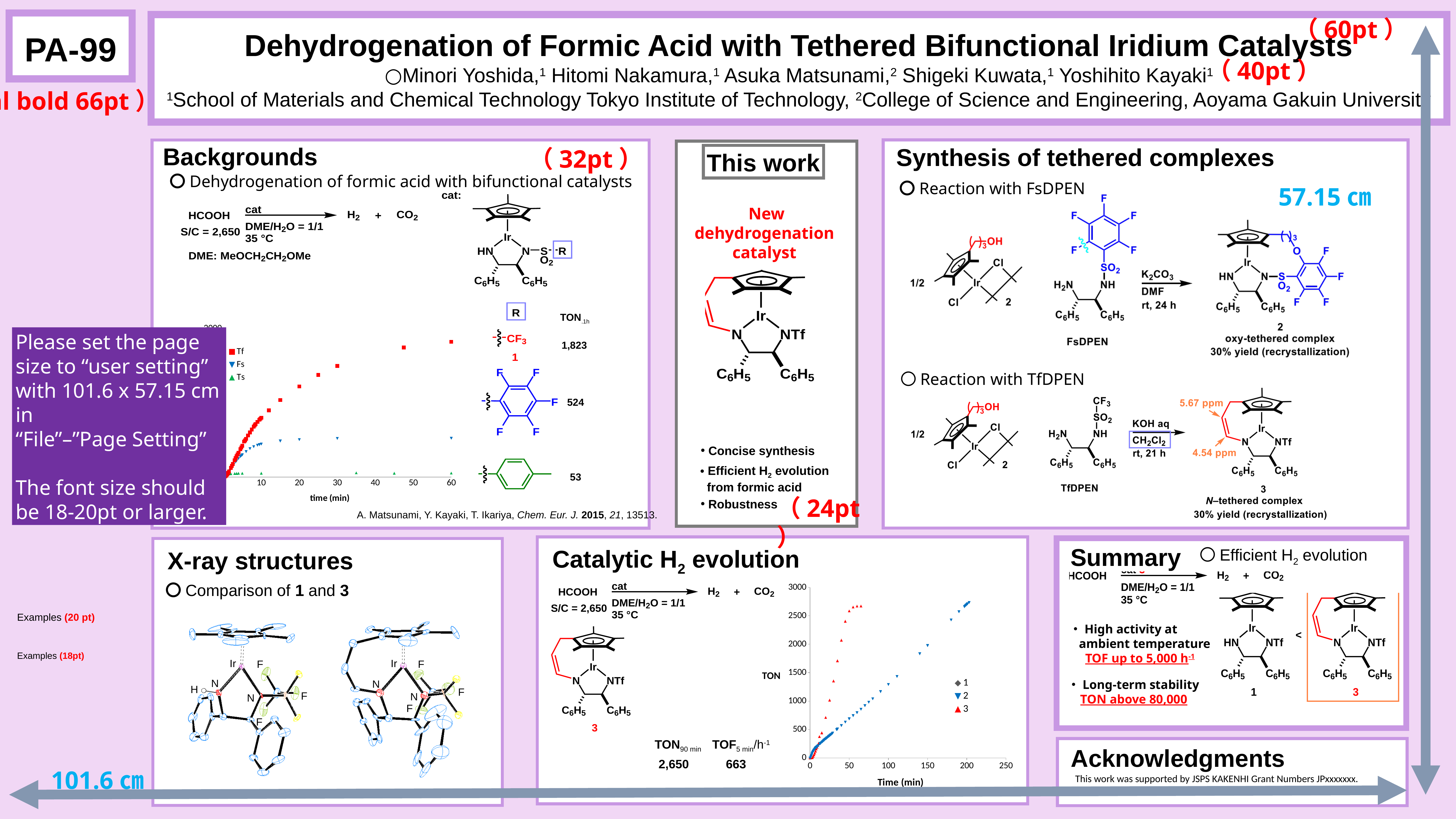
In the Catalytic H2 evolution chart, what is the label of the x axis? Time (min) In the Catalytic H2 evolution chart, which series reaches a TON of 2500 in the shortest time? 3 In the Backgrounds chart (TON vs time), how many series does the legend list? 3 In the Catalytic H2 evolution chart, how many series does the legend list? 3 In the Backgrounds chart (TON vs time), which series reaches the highest TON? Tf In the Backgrounds chart (TON vs time), which series has the lowest TON? Ts In the Catalytic H2 evolution chart, at 50 min, is the TON for series 2 greater or less than 1000? less In the Catalytic H2 evolution chart, does the TON for series 3 rise or fall as time increases? rise In the Catalytic H2 evolution chart, what is the label of the y axis? TON In the Catalytic H2 evolution chart, at 50 min, is the TON for series 3 greater or less than 2000? greater In the Catalytic H2 evolution chart, at 50 min, which series has the higher TON, 2 or 3? 3 In the Catalytic H2 evolution chart, what kind of chart is shown? scatter chart